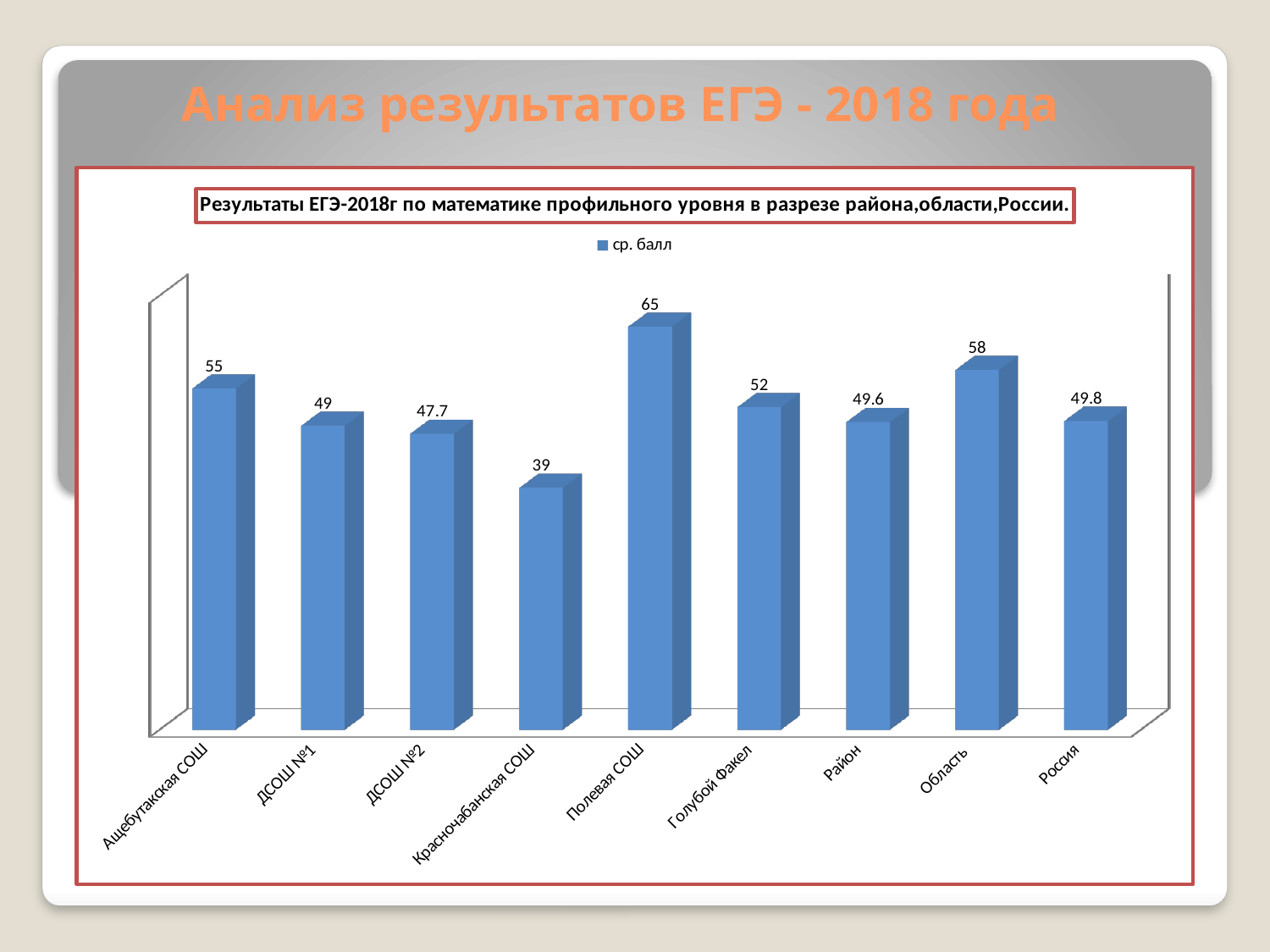
What kind of chart is shown on the slide? Bar chart How many series does the legend list? 1 What is the difference between the values for Область and Район? 8.4 What is the value shown for Район? 49.6 How many categories are shown on the x axis? 9 What is the value shown for Россия? 49.8 Which category has the highest average score? Полевая СОШ Which category has the lowest average score? Красночабанская СОШ What is the value shown for Красночабанская СОШ? 39 Which is larger, the value for Ащебутакская СОШ or the value for Голубой Факел? Ащебутакская СОШ What is the average score (ср. балл) for Полевая СОШ? 65 What is the legend entry of the chart? ср. балл